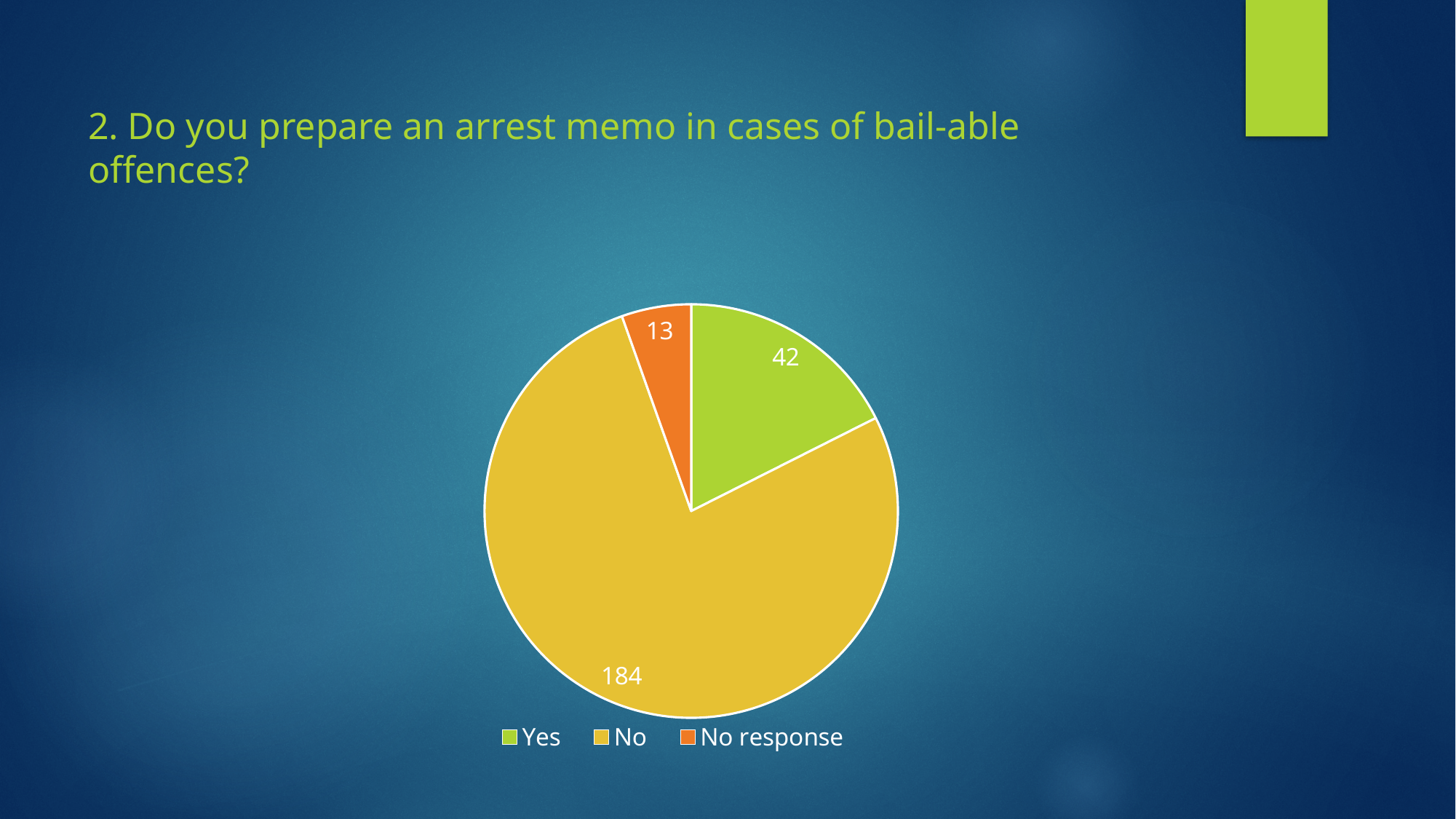
What is the difference between the values for "Yes" and "No response"? 29 How many slices does the pie chart have? 3 What kind of chart is shown on the slide? pie chart What is the difference between the values for "No" and "Yes"? 142 What is the value for "No response"? 13 What is the total of all slices in the pie chart? 239 What is the value for "Yes"? 42 Which legend entry is shown in orange? No response Which is larger, the value for "Yes" or the value for "No response"? Yes Which category has the largest slice? No Which category has the smallest slice? No response What is the value for "No"? 184